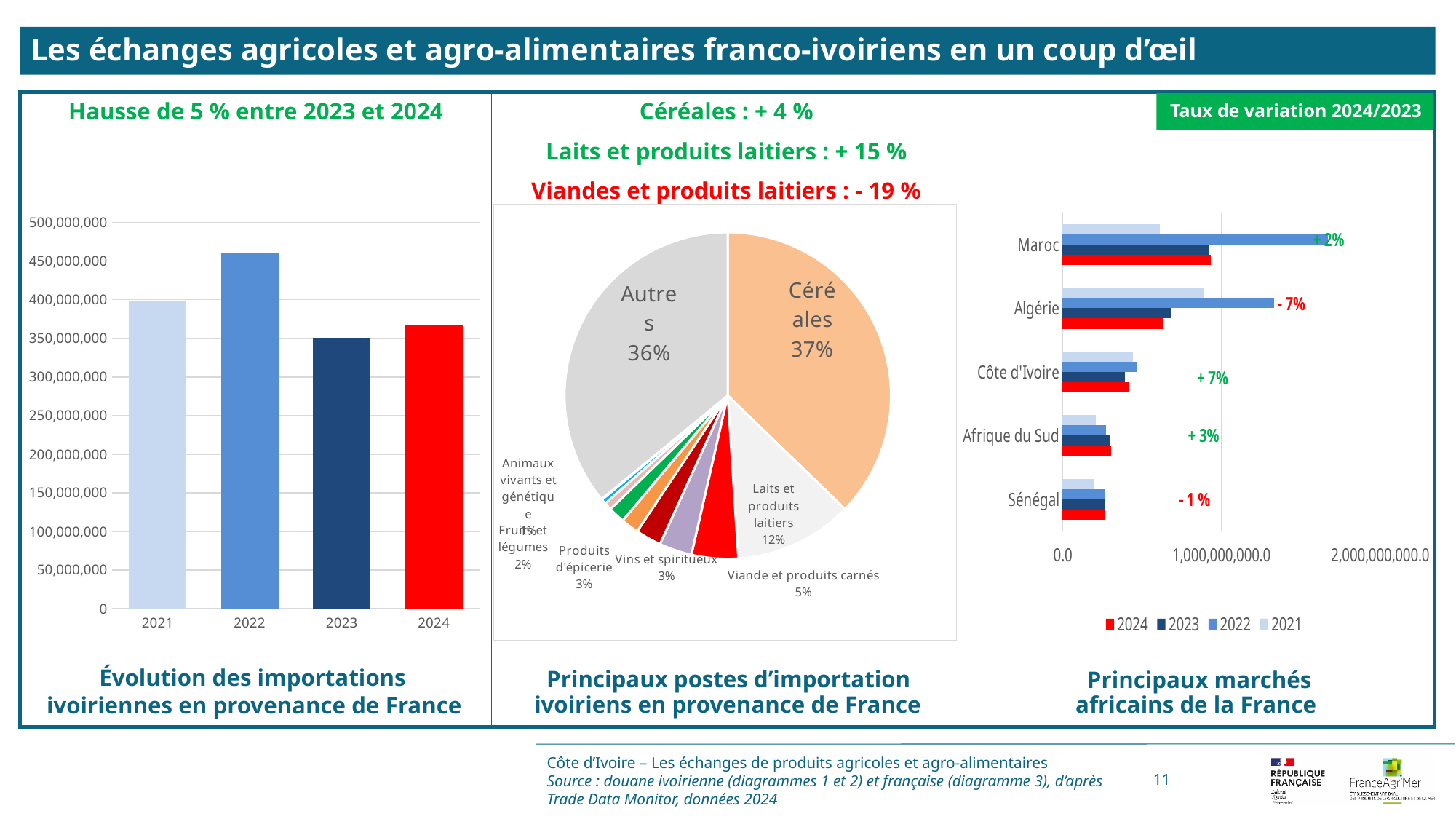
In the left chart 'Évolution des importations ivoiriennes en provenance de France', is the value for 2022 greater or less than 400,000,000? greater In the left chart 'Évolution des importations ivoiriennes en provenance de France', how many years are plotted? 4 In the middle pie chart 'Principaux postes d'importation ivoiriens en provenance de France', what share does Céréales have? 37% In the left chart 'Évolution des importations ivoiriennes en provenance de France', which year has the lowest value? 2023 In the right chart 'Principaux marchés africains de la France', what variation rate is shown next to Côte d'Ivoire? + 7% In the left chart 'Évolution des importations ivoiriennes en provenance de France', which year has the highest value? 2022 In the right chart 'Principaux marchés africains de la France', is the 2022 value for Maroc greater or less than 1,000,000,000.0? greater What kind of chart is the left chart, 'Évolution des importations ivoiriennes en provenance de France'? bar chart In the middle pie chart 'Principaux postes d'importation ivoiriens en provenance de France', what is the difference in percentage points between Céréales and Laits et produits laitiers? 25 In the middle pie chart 'Principaux postes d'importation ivoiriens en provenance de France', what share does Laits et produits laitiers have? 12% In the right chart 'Principaux marchés africains de la France', how many series does the legend list? 4 In the left chart 'Évolution des importations ivoiriennes en provenance de France', is the value for 2023 greater or less than 400,000,000? less